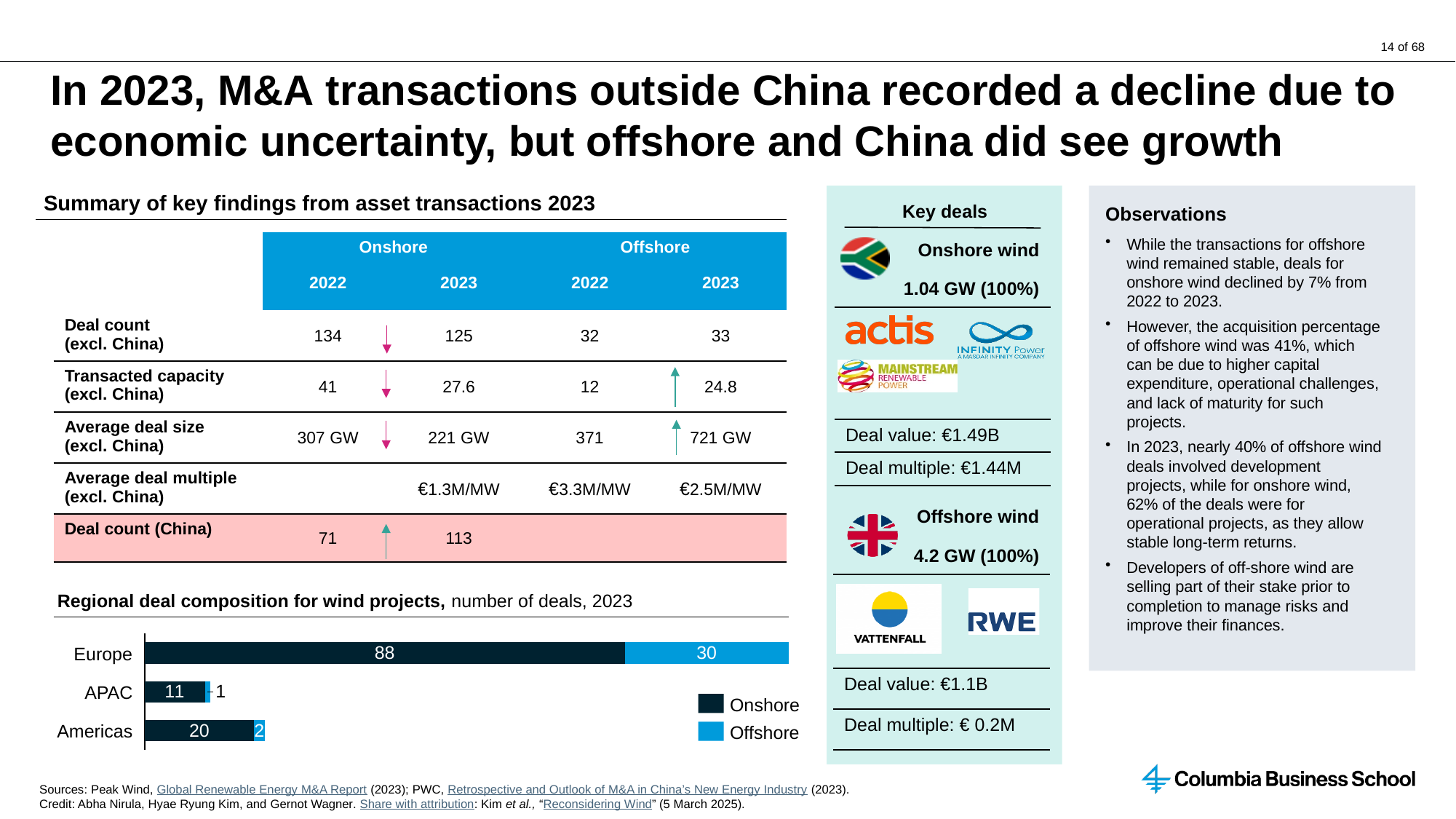
In the 'Regional deal composition for wind projects' chart, which region has the lowest number of offshore deals? APAC In the 'Regional deal composition for wind projects' chart, how many onshore deals are shown for APAC? 11 How many series does the legend of the 'Regional deal composition for wind projects' chart list? 2 In the 'Regional deal composition for wind projects' chart, what is the difference between onshore deals in Europe and onshore deals in the Americas? 68 In the 'Regional deal composition for wind projects' chart, how many onshore deals are shown for Europe? 88 In the 'Regional deal composition for wind projects' chart, how many offshore deals are shown for Europe? 30 In the 'Regional deal composition for wind projects' chart, what is the total number of deals for Europe (onshore plus offshore)? 118 In the 'Regional deal composition for wind projects' chart, which has more onshore deals, APAC or the Americas? Americas How many regions are shown in the 'Regional deal composition for wind projects' chart? 3 In the 'Regional deal composition for wind projects' chart, what is the total number of deals for the Americas? 22 In the 'Regional deal composition for wind projects' chart, how many offshore deals are shown for the Americas? 2 In the 'Regional deal composition for wind projects' chart, which region has the highest number of onshore deals? Europe